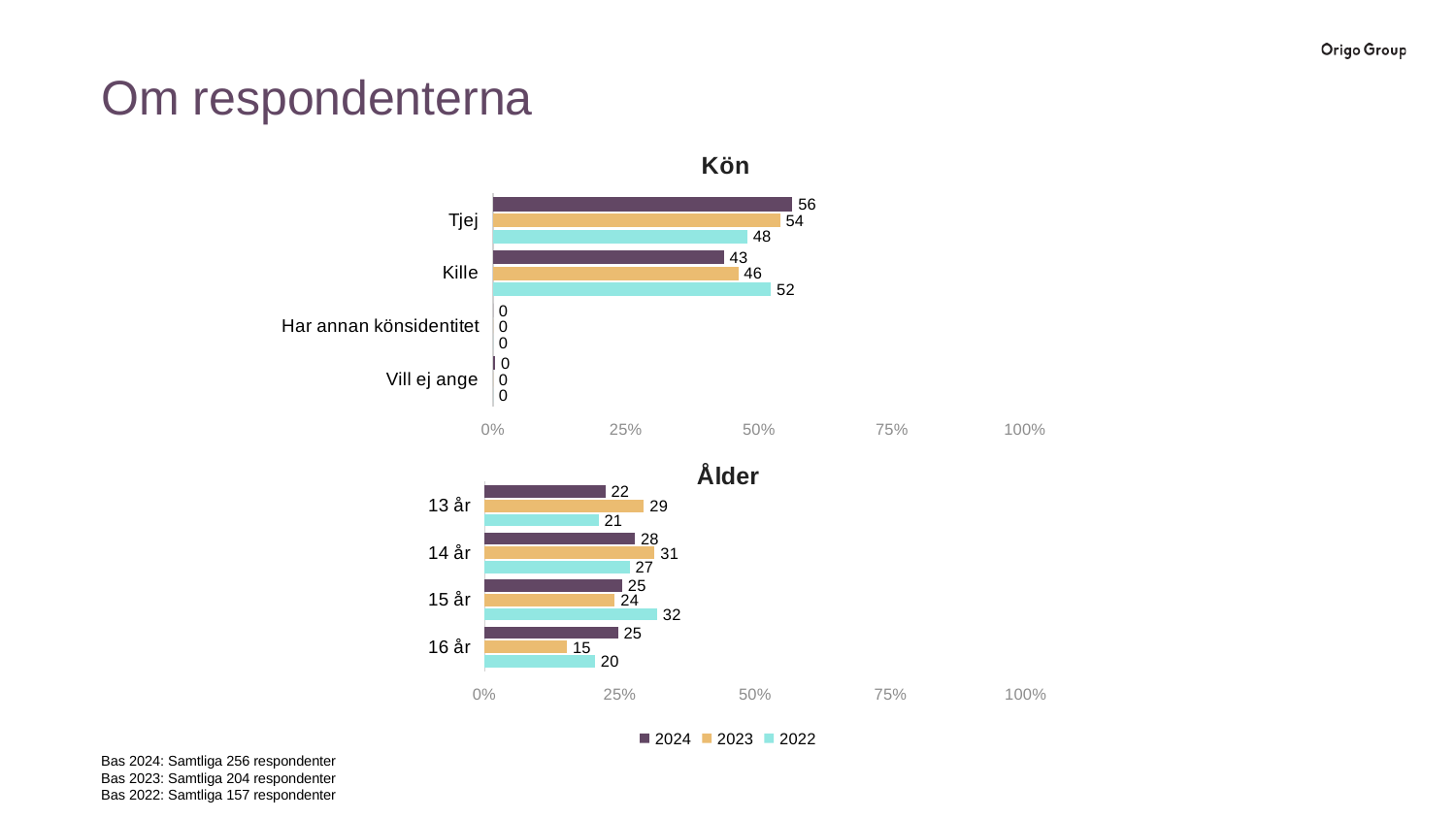
In the Ålder chart, what is the value for 16 år in 2023? 15 In the Kön chart, what is the difference between the 2024 values for Tjej and Kille? 13 In the Ålder chart, which age group has the highest value in 2024? 14 år In the Ålder chart, which age group has the lowest value in 2023? 16 år In the Ålder chart, is the 2022 value for 13 år larger or smaller than the 2023 value for 13 år? smaller In the Kön chart, which category has the highest value in 2023? Tjej In the Kön chart, what is the value for Tjej in 2024? 56 In the Ålder chart, what is the value for 15 år in 2022? 32 How many series does the legend list? 3 In the Kön chart, how many categories are shown? 4 What type of chart is the Ålder chart? bar chart In the Kön chart, what is the value for Kille in 2022? 52